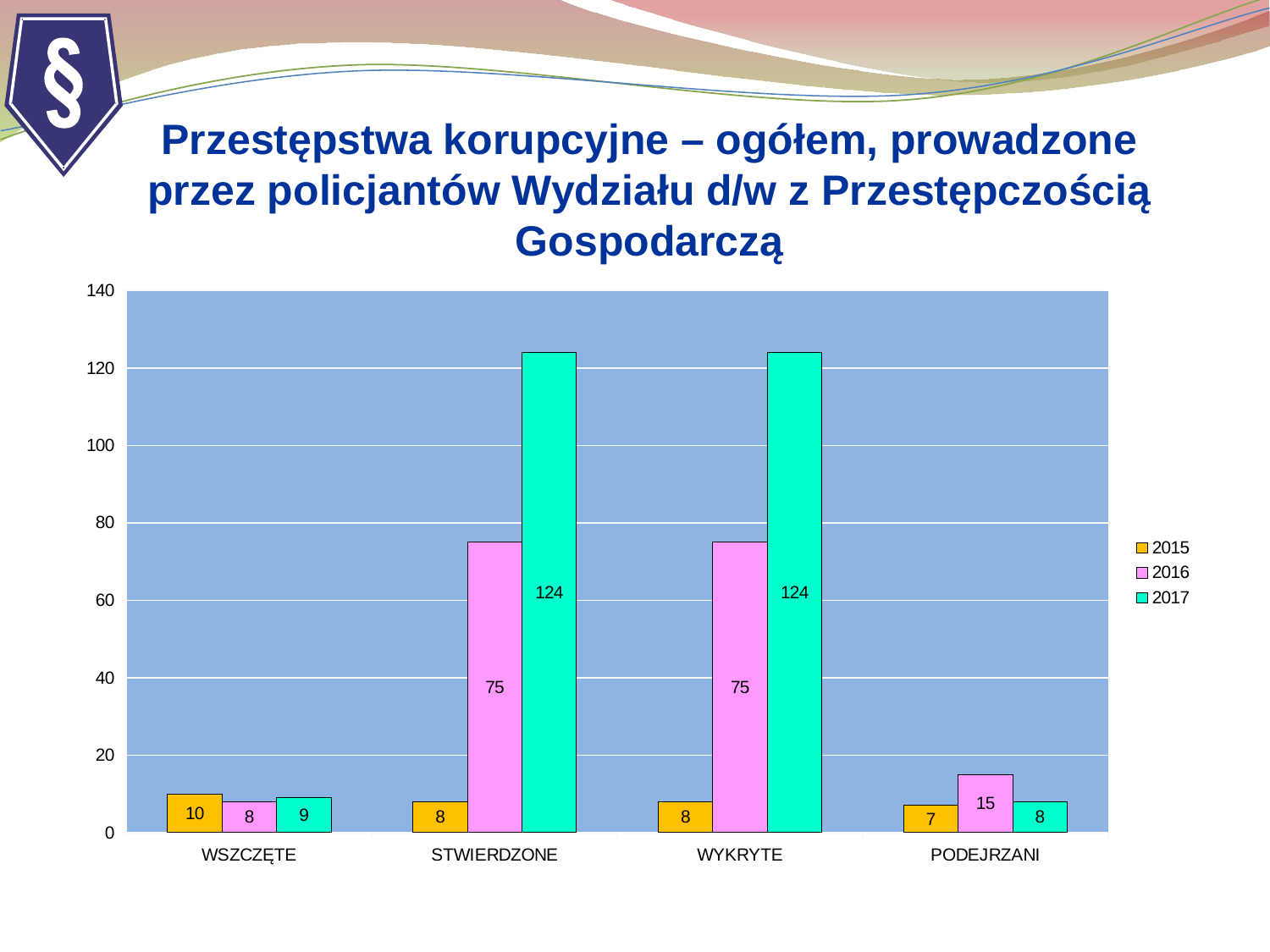
How many categories are shown on the x axis? 4 What is the value for 2017 in the STWIERDZONE category? 124 Which colour represents the 2017 series in the legend? turquoise (green-blue) Which category has the lowest value for the 2015 series? PODEJRZANI Which is larger: the 2016 value for PODEJRZANI or the 2017 value for PODEJRZANI? 2016 What is the value for 2016 in the PODEJRZANI category? 15 What is the value for 2015 in the WSZCZĘTE category? 10 Which category has the highest value for the 2016 series? STWIERDZONE and WYKRYTE (both 75) What kind of chart is shown on the slide? bar chart How many series does the legend list? 3 What is the difference between the 2017 and 2016 values in the WYKRYTE category? 49 Is the value for 2017 in the STWIERDZONE category greater or less than 120? greater